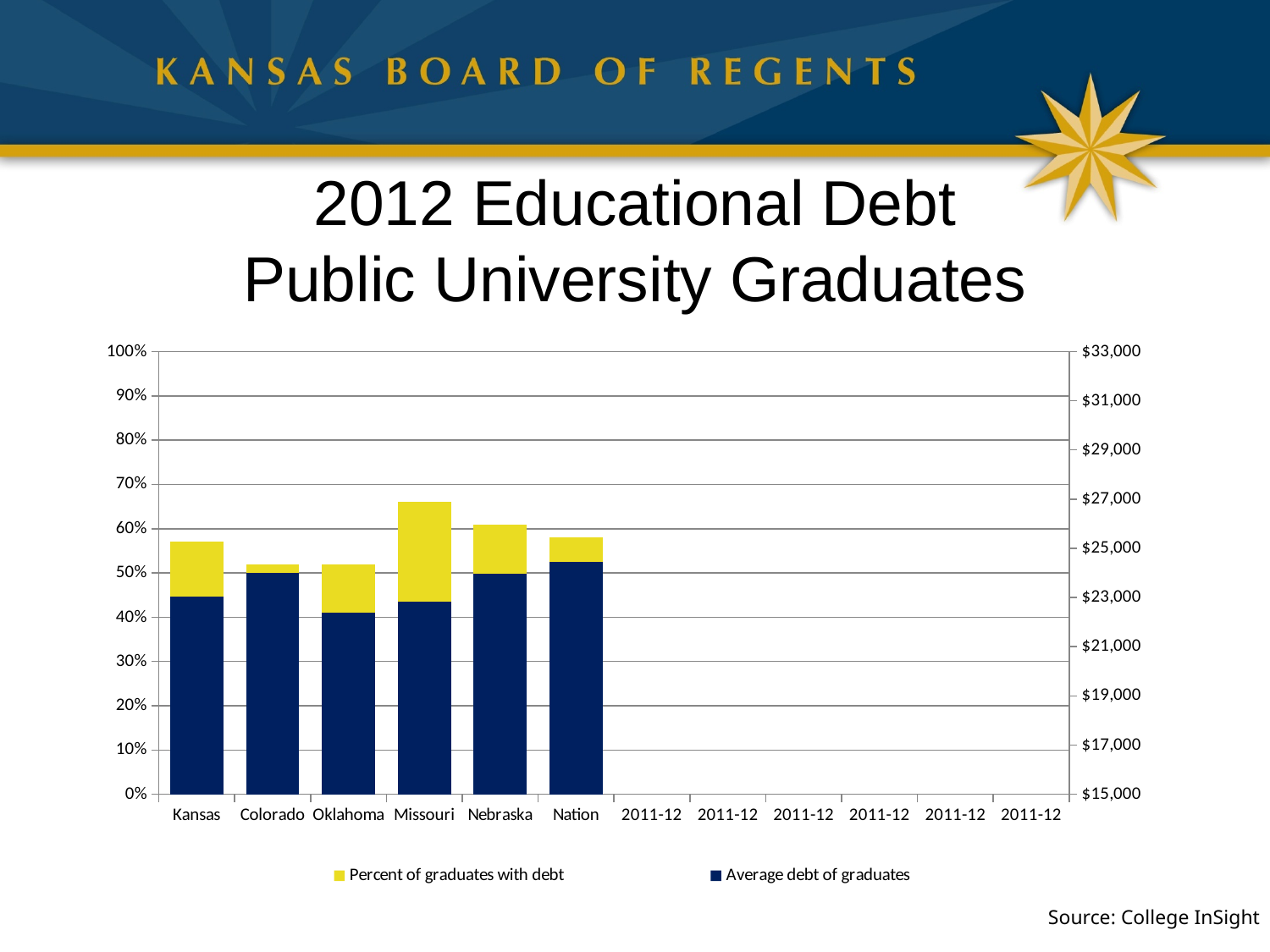
Is the 'Average debt of graduates' segment for Kansas greater or less than 50% on the left axis? less Which category has the tallest stacked bar overall? Missouri Which colour represents 'Percent of graduates with debt' in the legend? Yellow How many categories have bars plotted in the chart? 6 Which category has the largest 'Percent of graduates with debt' segment? Missouri Which stacked bar is taller overall, Missouri or Kansas? Missouri Which category has the smallest 'Percent of graduates with debt' segment? Colorado How many series does the legend list? 2 What is the highest value shown on the right-hand axis? $33,000 What kind of chart is shown on the slide? Stacked bar chart Is the 'Average debt of graduates' segment for Oklahoma greater or less than 50% on the left axis? less Is the top of the stacked bar for Missouri greater or less than 60% on the left axis? greater